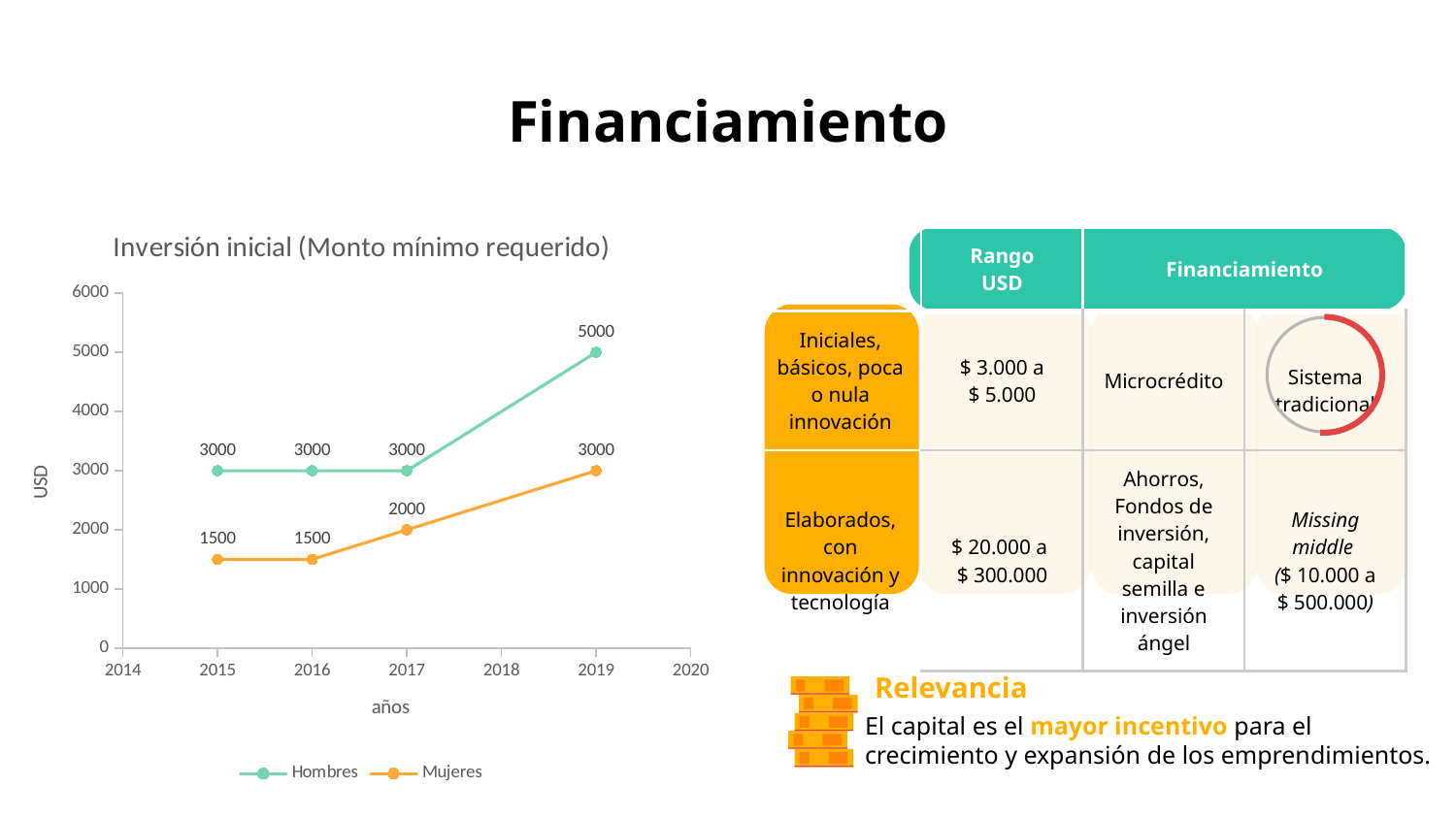
In which year is the value for Mujeres lowest? 2015 and 2016 What is the title of the chart? Inversión inicial (Monto mínimo requerido) What is the value for Mujeres in 2017? 2000 Which series has the larger value in 2017, Hombres or Mujeres? Hombres Does the value for Mujeres rise or fall from 2015 to 2019? rise What is the difference between Hombres and Mujeres in 2019? 2000 How many series does the legend list? 2 What is the value for Hombres in 2016? 3000 What type of chart is shown on the slide? line chart In which year is the value for Hombres highest? 2019 What is the value for Hombres in 2019? 5000 What is the value for Mujeres in 2015? 1500